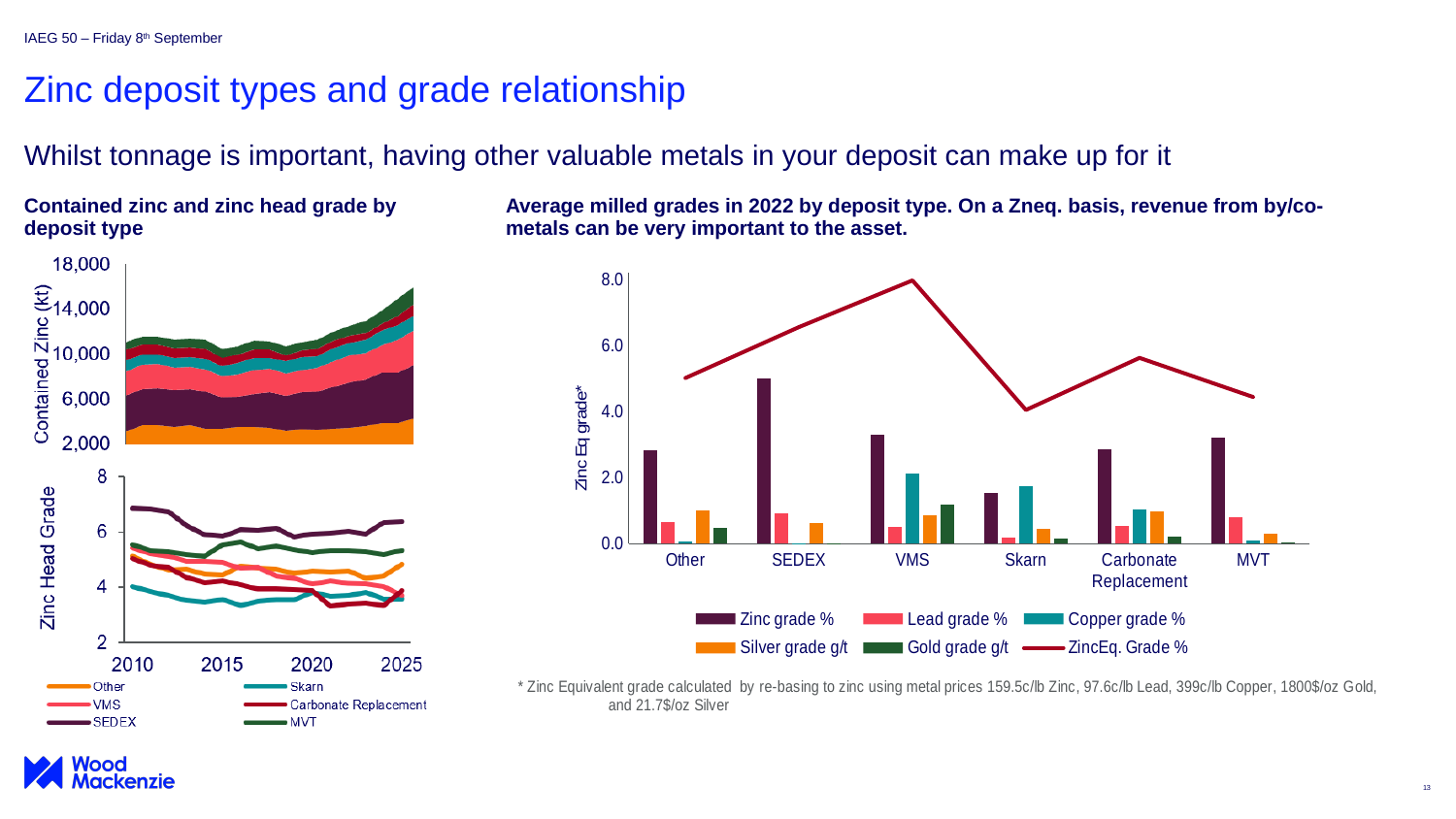
In the 'Zinc Head Grade' line chart on the left of the slide, does the SEDEX line rise or fall between 2010 and 2020? fall In the 'Average milled grades in 2022 by deposit type' chart, which deposit type has the highest Zinc grade % bar? SEDEX What kind of chart is the 'Contained Zinc (kt)' chart on the left of the slide? Stacked area chart In the 'Average milled grades in 2022 by deposit type' chart, how many series does the legend list? 6 In the 'Average milled grades in 2022 by deposit type' chart, how many deposit types are shown on the x axis? 6 In the 'Zinc Head Grade' line chart on the left of the slide, is the SEDEX value in 2010 greater or less than 6? greater In the 'Average milled grades in 2022 by deposit type' chart, at which deposit type does the ZincEq. Grade % line reach its lowest point? Skarn In the 'Average milled grades in 2022 by deposit type' chart, which deposit type has the lowest Zinc grade % bar? Skarn In the 'Average milled grades in 2022 by deposit type' chart, which deposit type has the highest Copper grade % bar? VMS In the 'Average milled grades in 2022 by deposit type' chart, at which deposit type does the ZincEq. Grade % line reach its highest point? VMS In the 'Average milled grades in 2022 by deposit type' chart, is the ZincEq. Grade % value for VMS greater or less than 6.0? greater In the 'Average milled grades in 2022 by deposit type' chart, is the Zinc grade % value for SEDEX greater or less than 4.0? greater